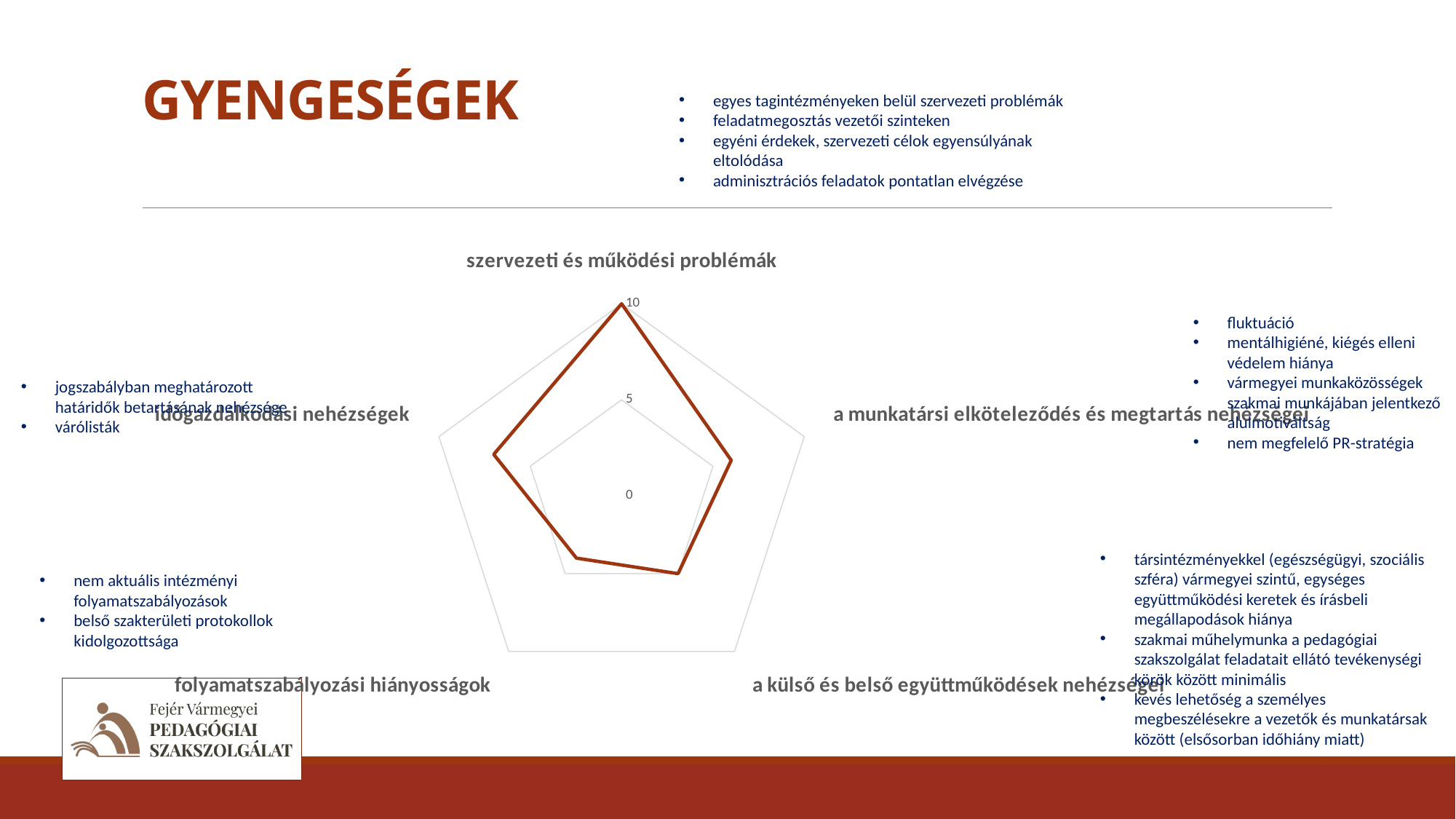
What is the maximum value shown on the radar chart's scale? 10 Is the value for 'folyamatszabályozási hiányosságok' greater or less than 10? less How many categories (axes) does the radar chart have? 5 What kind of chart is shown on the slide? radar chart Which is larger: the value for 'szervezeti és működési problémák' or the value for 'folyamatszabályozási hiányosságok'? szervezeti és működési problémák Is the value for 'időgazdálkodási nehézségek' greater or less than 5? greater What is the value for 'szervezeti és működési problémák' on the radar chart? 10 Which category has the highest value on the radar chart? szervezeti és működési problémák What is the title of the slide containing the radar chart? GYENGESÉGEK Which is larger: the value for 'időgazdálkodási nehézségek' or the value for 'a külső és belső együttműködések nehézségei'? időgazdálkodási nehézségek